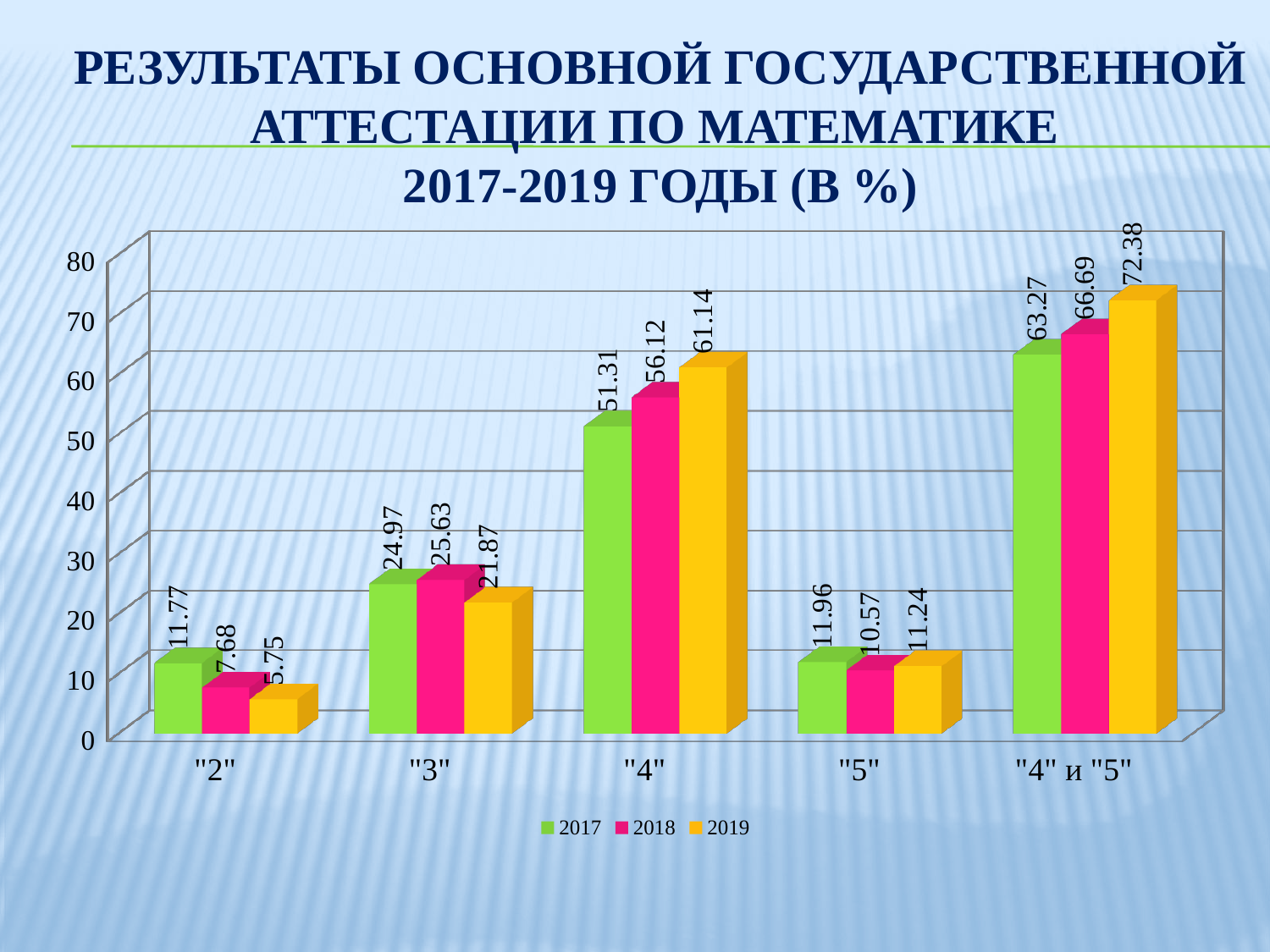
What is the value for "5" in 2019? 11.24 Is the value for "4" in 2017 greater or less than 50? greater How many series does the legend list? 3 Which category has the lowest value in 2019? "2" How many categories are shown on the x axis? 5 What is the value for "2" in 2017? 11.77 Which category has the highest value in 2019? "4" и "5" What is the value for "4" и "5" in 2018? 66.69 Which is larger for "3": the 2018 value or the 2019 value? 2018 What is the difference between the 2019 and 2017 values for "4" и "5"? 9.11 What kind of chart is shown on the slide? bar chart What is the value for "4" in 2019? 61.14